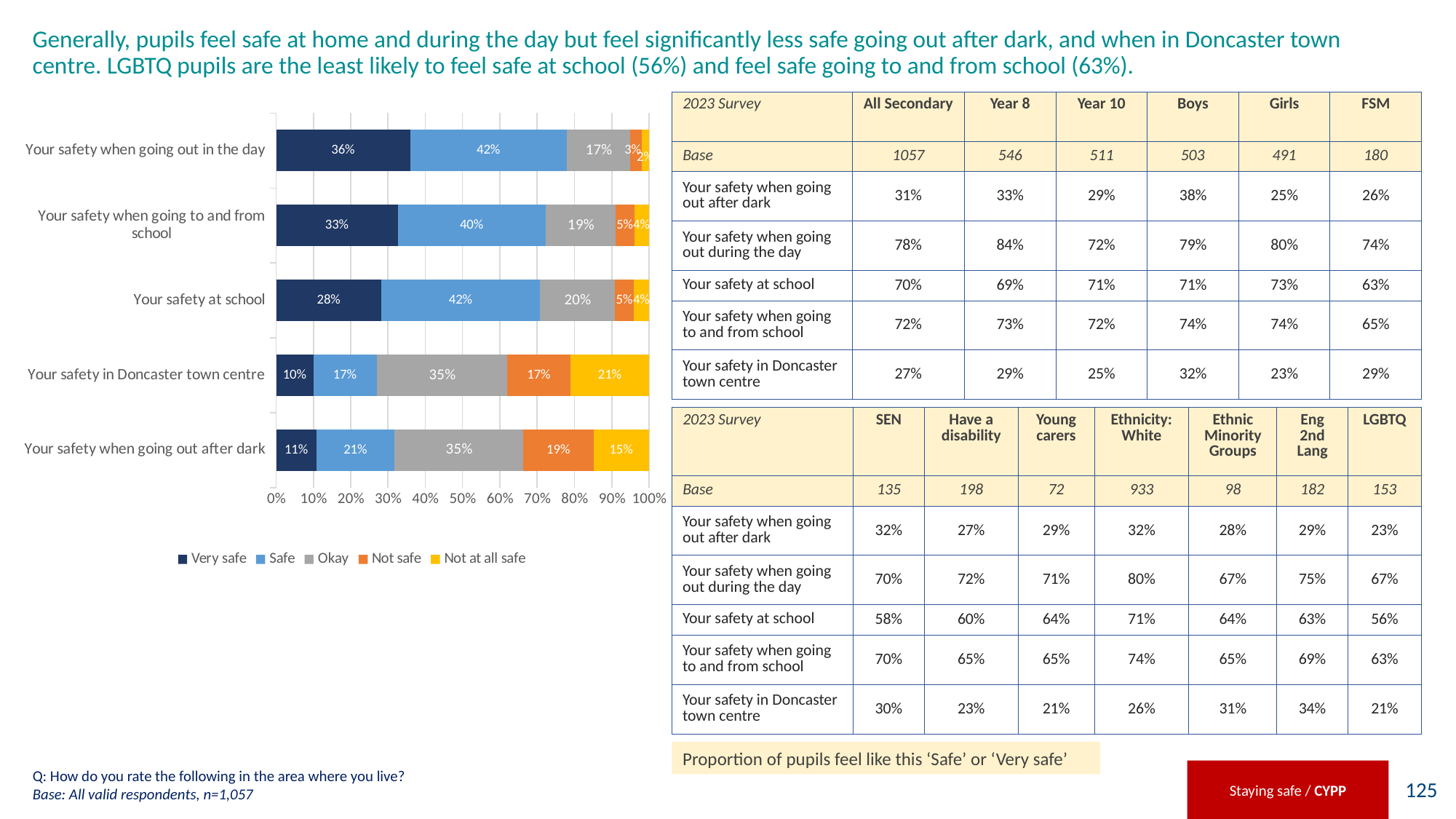
What kind of chart is shown on the slide? Stacked bar chart Which is larger: the 'Not safe' value for 'Your safety when going out after dark' or for 'Your safety in Doncaster town centre'? Your safety when going out after dark What is the 'Not at all safe' value for 'Your safety in Doncaster town centre'? 21% How many categories are plotted in the chart? 5 Which colour represents the 'Not at all safe' series in the chart? Yellow Which category has the lowest 'Very safe' value? Your safety in Doncaster town centre What is the combined 'Very safe' and 'Safe' total for 'Your safety when going to and from school'? 73% What is the 'Very safe' value for 'Your safety when going out in the day'? 36% What is the difference between the 'Safe' values for 'Your safety at school' and 'Your safety when going out after dark'? 21% What is the 'Okay' value for 'Your safety when going out after dark'? 35% Which category has the highest 'Very safe' value? Your safety when going out in the day How many series does the chart legend list? 5